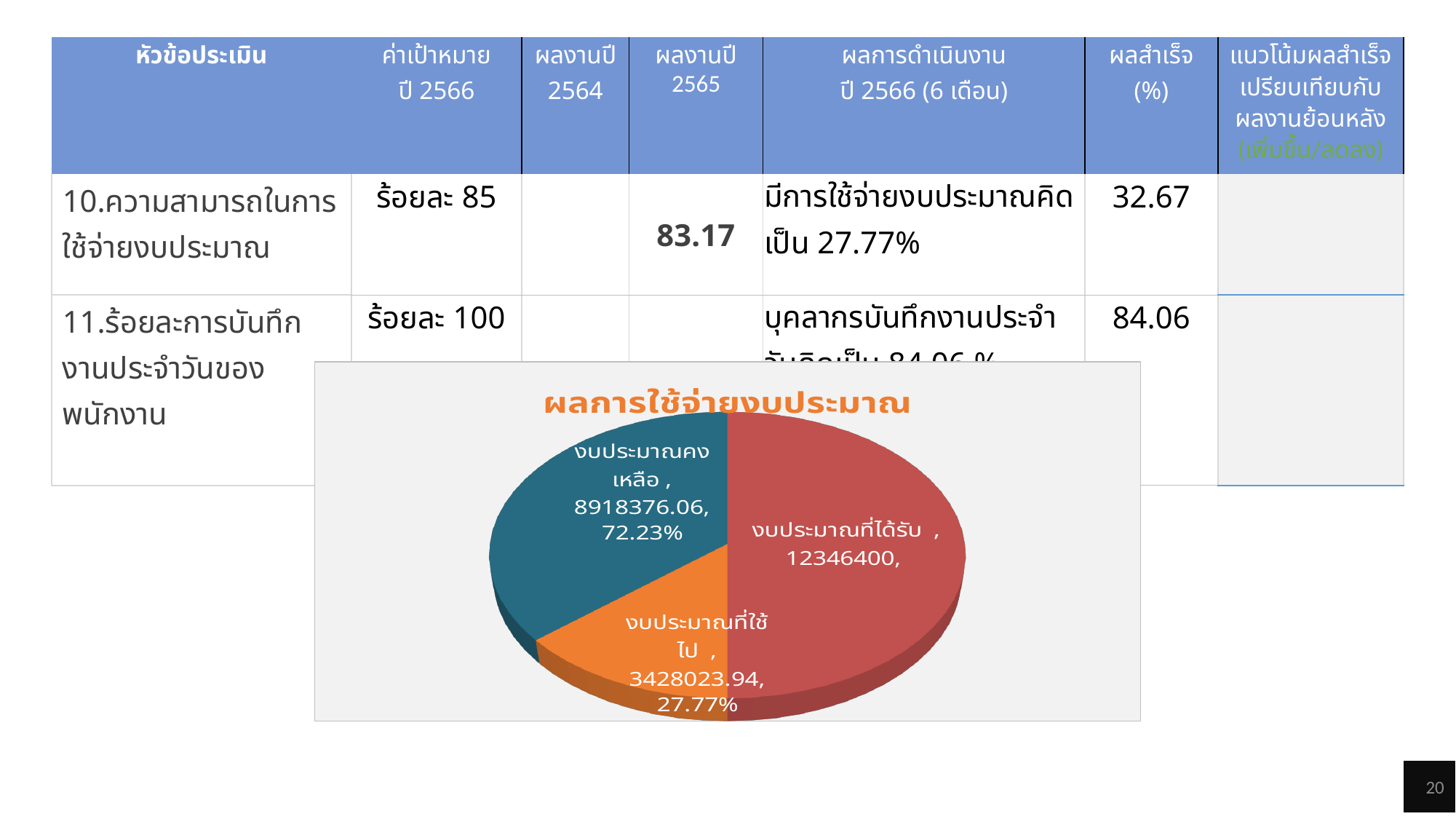
How many slices does the pie chart have? 3 What percentage is printed on the งบประมาณที่ใช้ไป slice? 27.77% What is the difference between the labelled values for งบประมาณคงเหลือ and งบประมาณที่ใช้ไป? 5490352.12 What percentage is printed on the งบประมาณคงเหลือ slice? 72.23% What value is labelled on the งบประมาณที่ได้รับ slice? 12346400 Which slice of the pie chart has the largest labelled value? งบประมาณที่ได้รับ Which is larger, the value for งบประมาณคงเหลือ or the value for งบประมาณที่ใช้ไป? งบประมาณคงเหลือ What kind of chart is shown on the slide? pie chart What value is labelled on the งบประมาณคงเหลือ slice? 8918376.06 What value is labelled on the งบประมาณที่ใช้ไป slice? 3428023.94 What is the title of the pie chart? ผลการใช้จ่ายงบประมาณ Which slice of the pie chart has the smallest labelled value? งบประมาณที่ใช้ไป